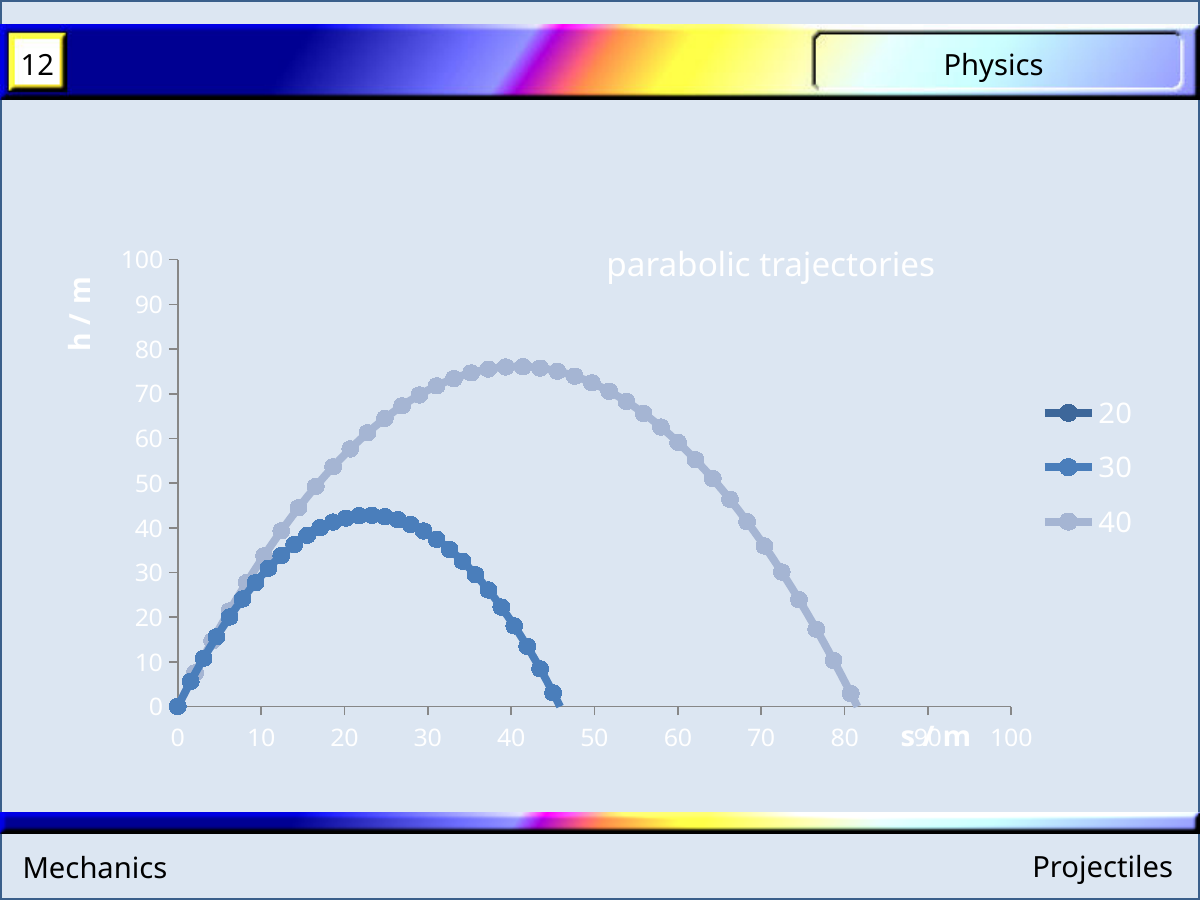
For the 30 series, does h rise or fall as s increases from 30 to 45? fall Is the maximum height reached by the 30 series greater or less than 50? less What kind of chart is shown on the slide? line chart Is the maximum height reached by the 40 series greater or less than 70? greater How many series does the legend list? 3 Is the horizontal distance at which the 40 series returns to h = 0 greater or less than 70? greater What is the label on the vertical axis? h / m What is the title of the chart? parabolic trajectories For the 40 series, does h rise or fall as s increases from 0 to 40? rise Which series reaches a greater maximum height, 30 or 40? 40 Which series travels a greater horizontal distance before returning to h = 0, 30 or 40? 40